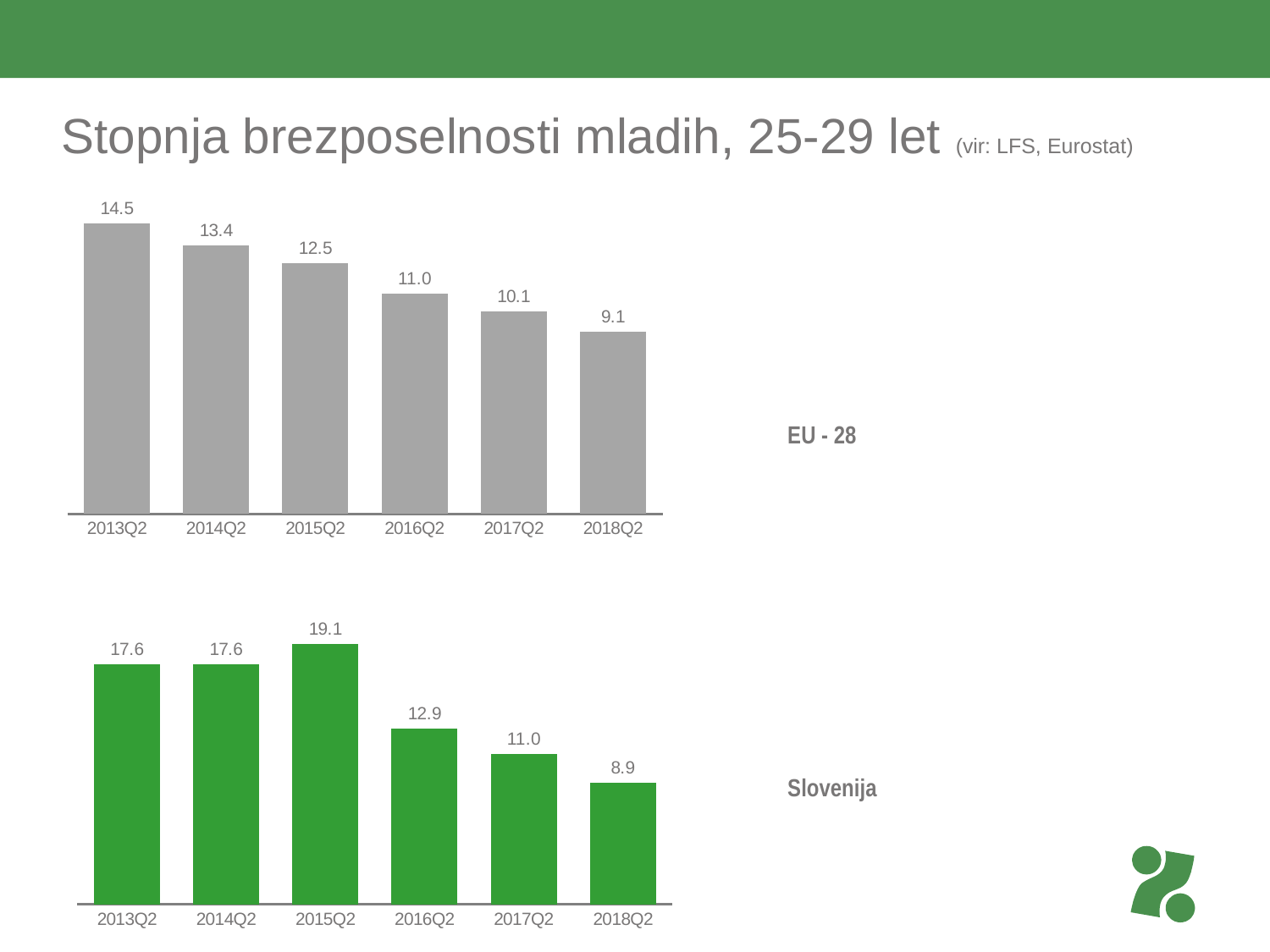
In the Slovenija chart (bottom), which quarter has the highest value? 2015Q2 In the Slovenija chart (bottom), what is the value for 2015Q2? 19.1 What kind of chart is the Slovenija chart (bottom)? Bar chart In the Slovenija chart (bottom), what is the difference between the 2015Q2 and 2016Q2 values? 6.2 Which is larger: the 2016Q2 value in the EU - 28 chart or the 2016Q2 value in the Slovenija chart? Slovenija In the EU - 28 chart (top), do the values rise or fall from 2013Q2 to 2018Q2? Fall In the EU - 28 chart (top), which quarter has the lowest value? 2018Q2 In the Slovenija chart (bottom), what is the value for 2018Q2? 8.9 In the EU - 28 chart (top), how many quarters are shown on the x axis? 6 In the EU - 28 chart (top), what is the value for 2013Q2? 14.5 In the EU - 28 chart (top), what is the difference between the 2013Q2 and 2018Q2 values? 5.4 What colour are the bars in the Slovenija chart (bottom)? Green